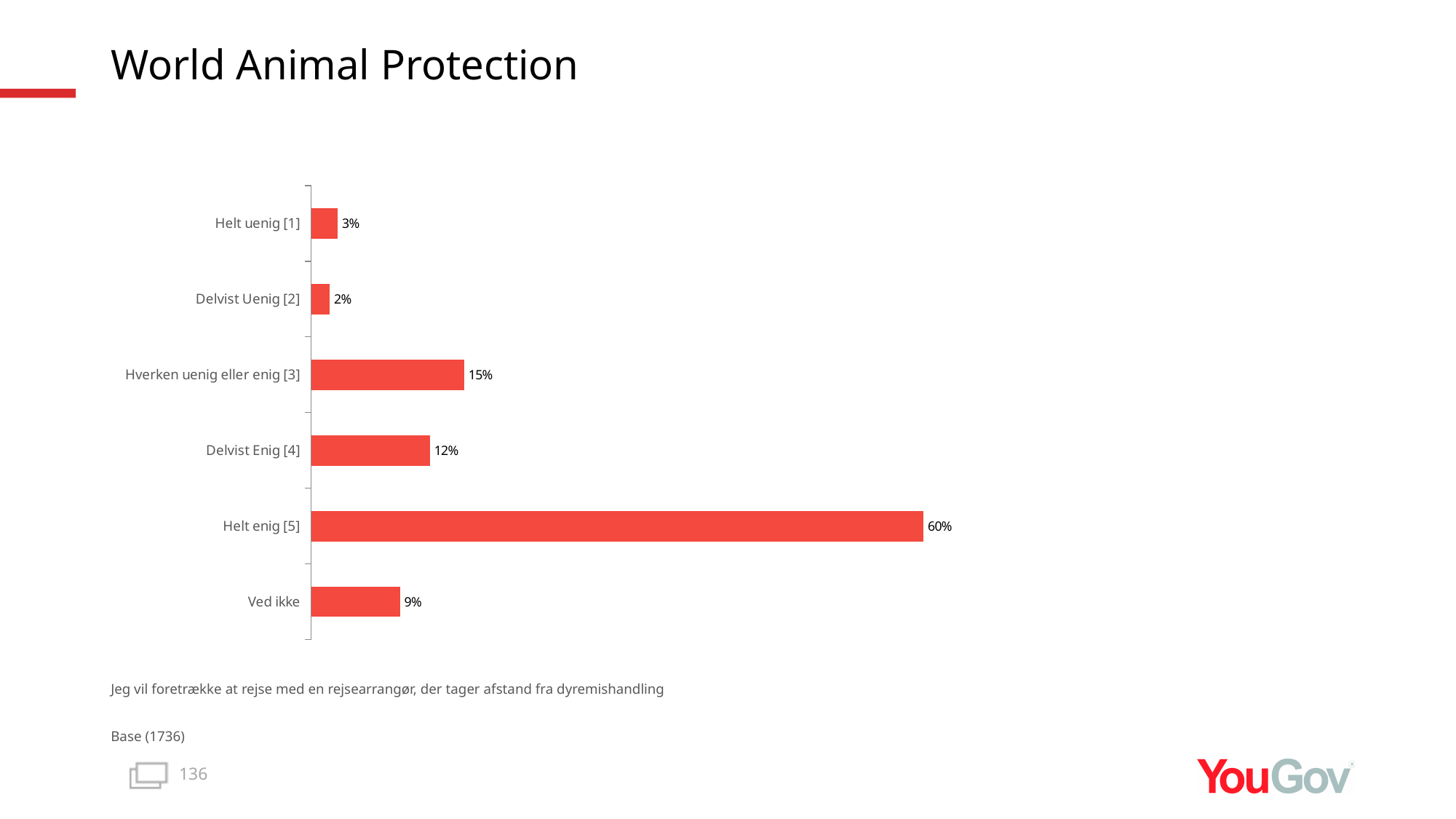
What is the value for "Delvist Uenig [2]"? 2% Which category has the highest value? Helt enig [5] What type of chart is shown on the slide? Bar chart What is the difference between "Hverken uenig eller enig [3]" and "Ved ikke"? 6% What is the value shown for "Hverken uenig eller enig [3]"? 15% What is the difference between "Helt enig [5]" and "Delvist Enig [4]"? 48% How many categories are shown in the chart? 6 What percentage of respondents answered "Helt enig [5]"? 60% Which is larger, the value for "Helt uenig [1]" or "Delvist Uenig [2]"? Helt uenig [1] Which category has the lowest value? Delvist Uenig [2] What percentage answered "Ved ikke"? 9% What is the base (number of respondents) stated below the chart? 1736